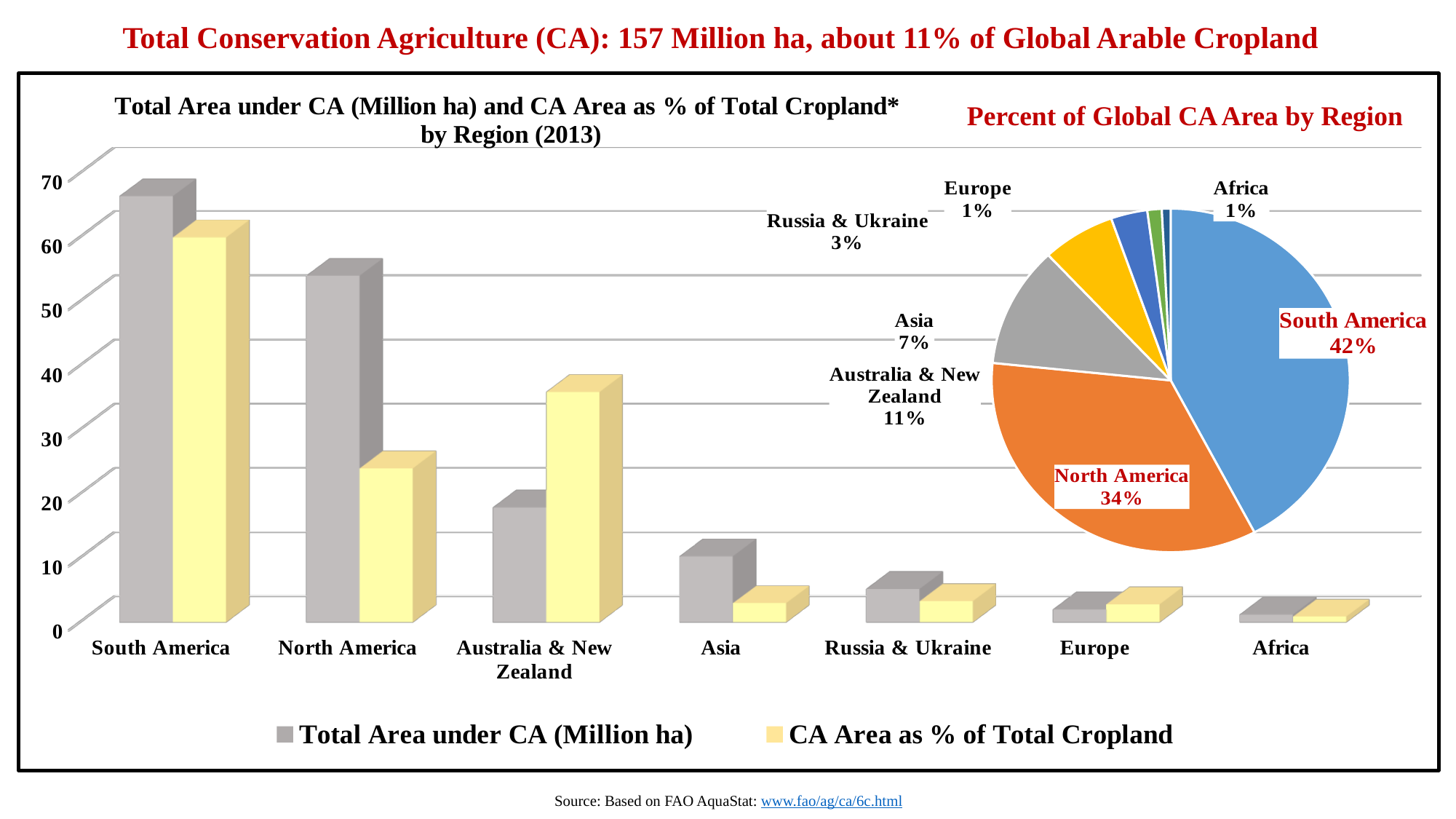
What kind of chart is 'Percent of Global CA Area by Region'? Pie chart In the 'Percent of Global CA Area by Region' pie chart, how many percentage points larger is South America's share than North America's? 8 In the bar chart on the left, which region has the highest Total Area under CA (Million ha)? South America In the bar chart on the left, how many series does the legend list? 2 In the 'Percent of Global CA Area by Region' pie chart, what share does Australia & New Zealand have? 11% In the bar chart on the left, which is larger for Australia & New Zealand: the Total Area under CA (Million ha) bar or the CA Area as % of Total Cropland bar? CA Area as % of Total Cropland In the bar chart on the left, is the Total Area under CA (Million ha) for South America greater or less than 60? greater In the bar chart on the left, is the Total Area under CA (Million ha) for Australia & New Zealand greater or less than 20? less In the 'Percent of Global CA Area by Region' pie chart, which region has the largest share? South America In the 'Percent of Global CA Area by Region' pie chart, how many regions are shown? 7 In the 'Percent of Global CA Area by Region' pie chart, what share does South America have? 42% What kind of chart is the chart on the left titled 'Total Area under CA (Million ha) and CA Area as % of Total Cropland by Region (2013)'? Bar chart